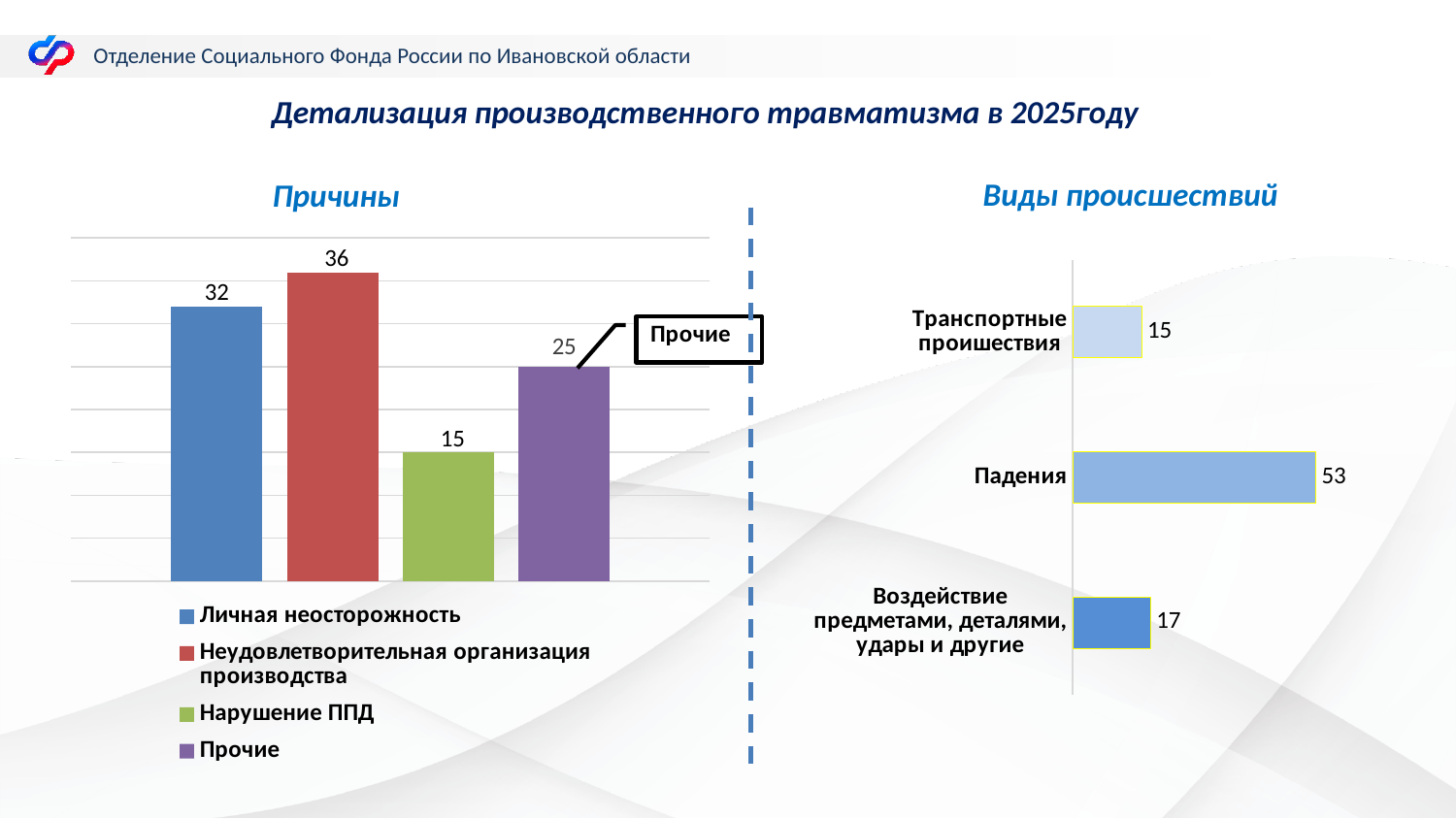
In the "Виды происшествий" chart, what is the value for Транспортные проишествия? 15 What kind of chart is the "Виды происшествий" chart? Bar chart In the "Причины" chart, what is the value for Нарушение ППД? 15 In the "Виды происшествий" chart, what is the difference between Падения and Воздействие предметами, деталями, удары и другие? 36 In the "Причины" chart, which category has the highest value? Неудовлетворительная организация производства In the "Причины" chart, what is the value for Личная неосторожность? 32 In the "Виды происшествий" chart, which category has the highest value? Падения In the "Причины" chart, what is the value for Неудовлетворительная организация производства? 36 In the "Причины" chart, what is the difference between Неудовлетворительная организация производства and Прочие? 11 In the "Причины" chart, how many entries does the legend list? 4 In the "Причины" chart, which category has the lowest value? Нарушение ППД In the "Виды происшествий" chart, what is the value for Падения? 53